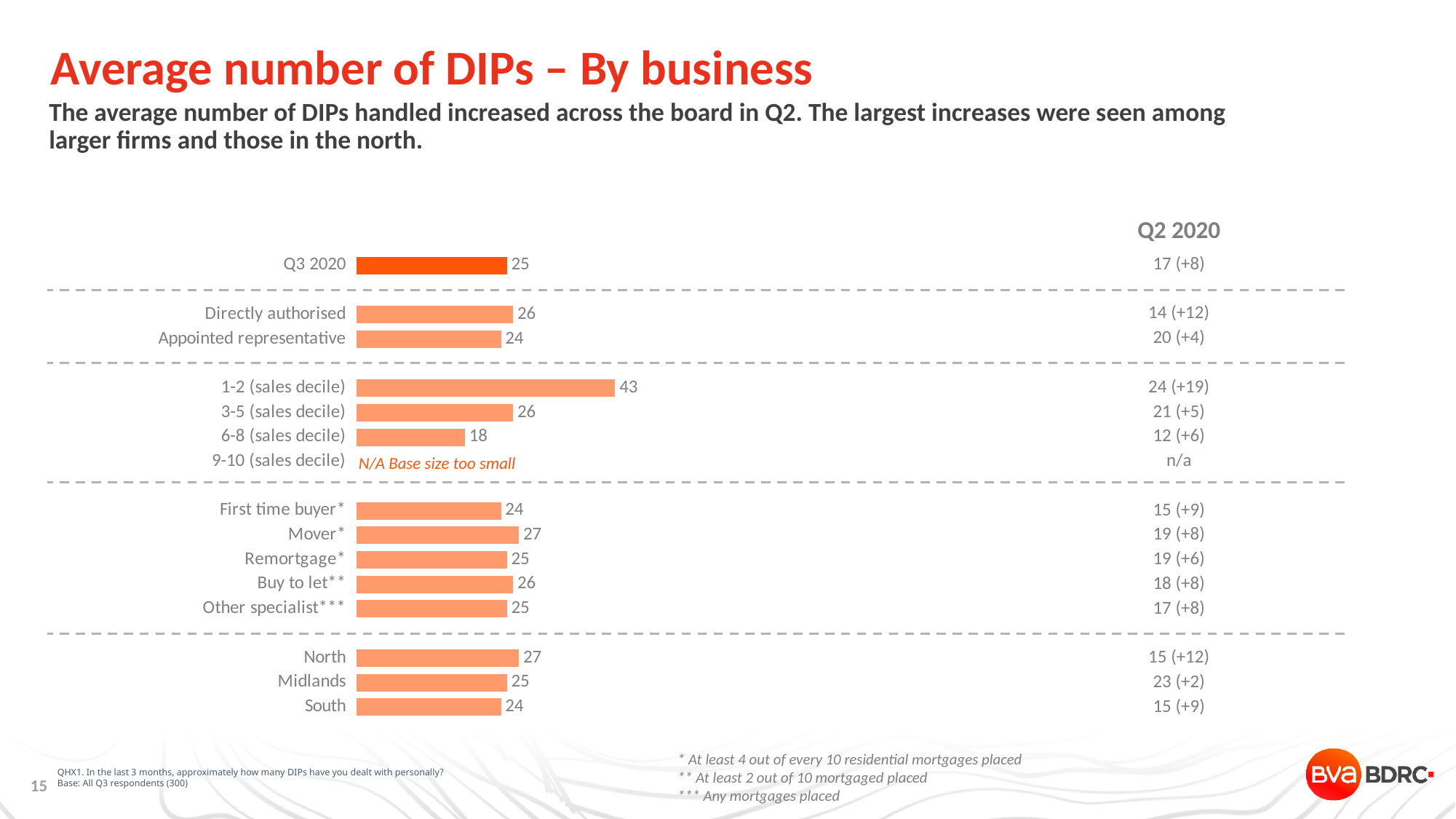
What is the value shown for Q3 2020 overall? 25 Which is larger, the value for Mover or the value for First time buyer? Mover Which category with a plotted bar has the lowest value? 6-8 (sales decile) Which is larger, the value for Directly authorised or the value for Appointed representative? Directly authorised What is the difference between the values for North and South? 3 How many bars are plotted in the chart? 14 Which category has the highest value in the chart? 1-2 (sales decile) What is the difference between the values for 1-2 (sales decile) and 6-8 (sales decile)? 25 What kind of chart is shown on the slide? Bar chart What is the average number of DIPs for the 1-2 (sales decile) category? 43 What is the value for Appointed representative? 24 What note is shown in place of a bar for the 9-10 (sales decile) category? N/A Base size too small